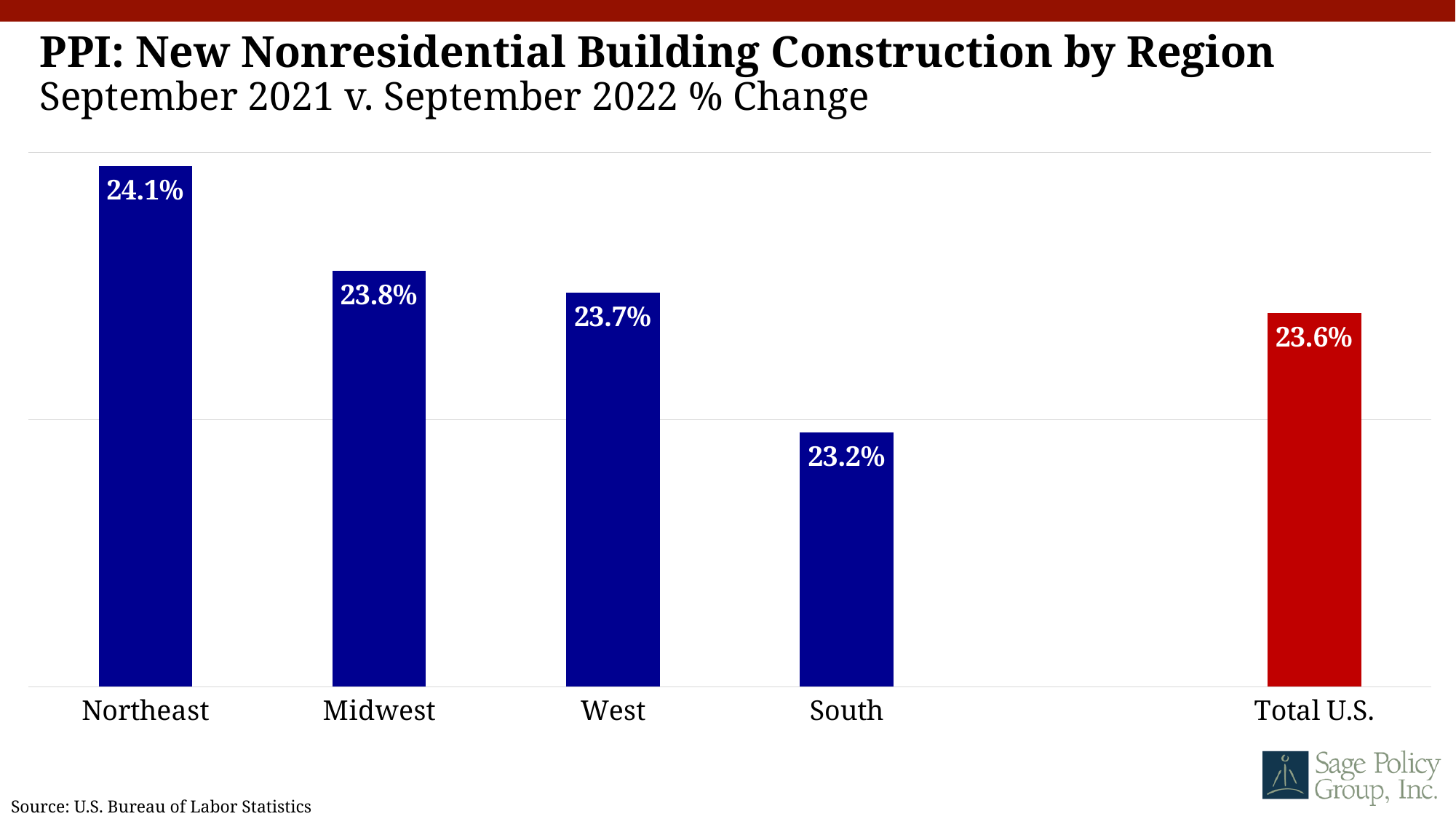
Which bar is coloured red rather than blue? Total U.S. What is the difference between the Midwest and Total U.S. percent changes? 0.2% What is the difference between the Northeast and South percent changes? 0.9% What is the percent change for the Northeast? 24.1% What type of chart is shown on the slide? Bar chart What is the percent change for the Midwest? 23.8% What is the percent change for Total U.S.? 23.6% How many bars are shown in the chart? 5 Which region has the lowest percent change? South What is the percent change for the South? 23.2% Which region has the highest percent change? Northeast Which has a larger percent change, the West or the South? West